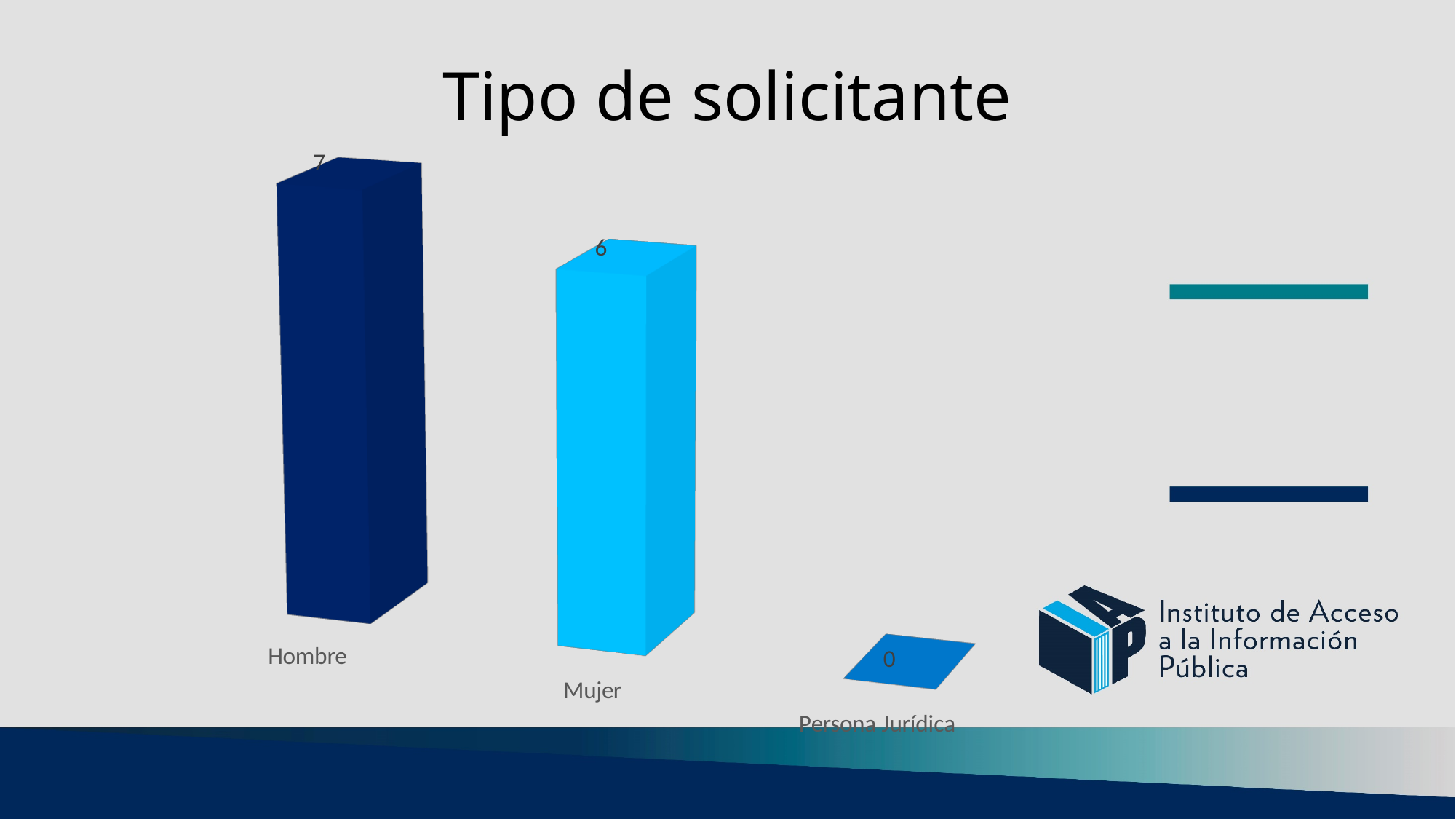
Which category has the lowest value? Persona Jurídica What is the difference between the values for Mujer and Persona Jurídica? 6 Which category has the highest value? Hombre What is the difference between the values for Hombre and Mujer? 1 What kind of chart is shown on the slide? bar chart What is the value for Mujer? 6 How many categories are shown in the chart? 3 Do the values rise or fall from left to right across the categories? fall What is the value for Hombre? 7 What is the title of the chart? Tipo de solicitante Which is larger, the value for Hombre or the value for Mujer? Hombre What is the value for Persona Jurídica? 0